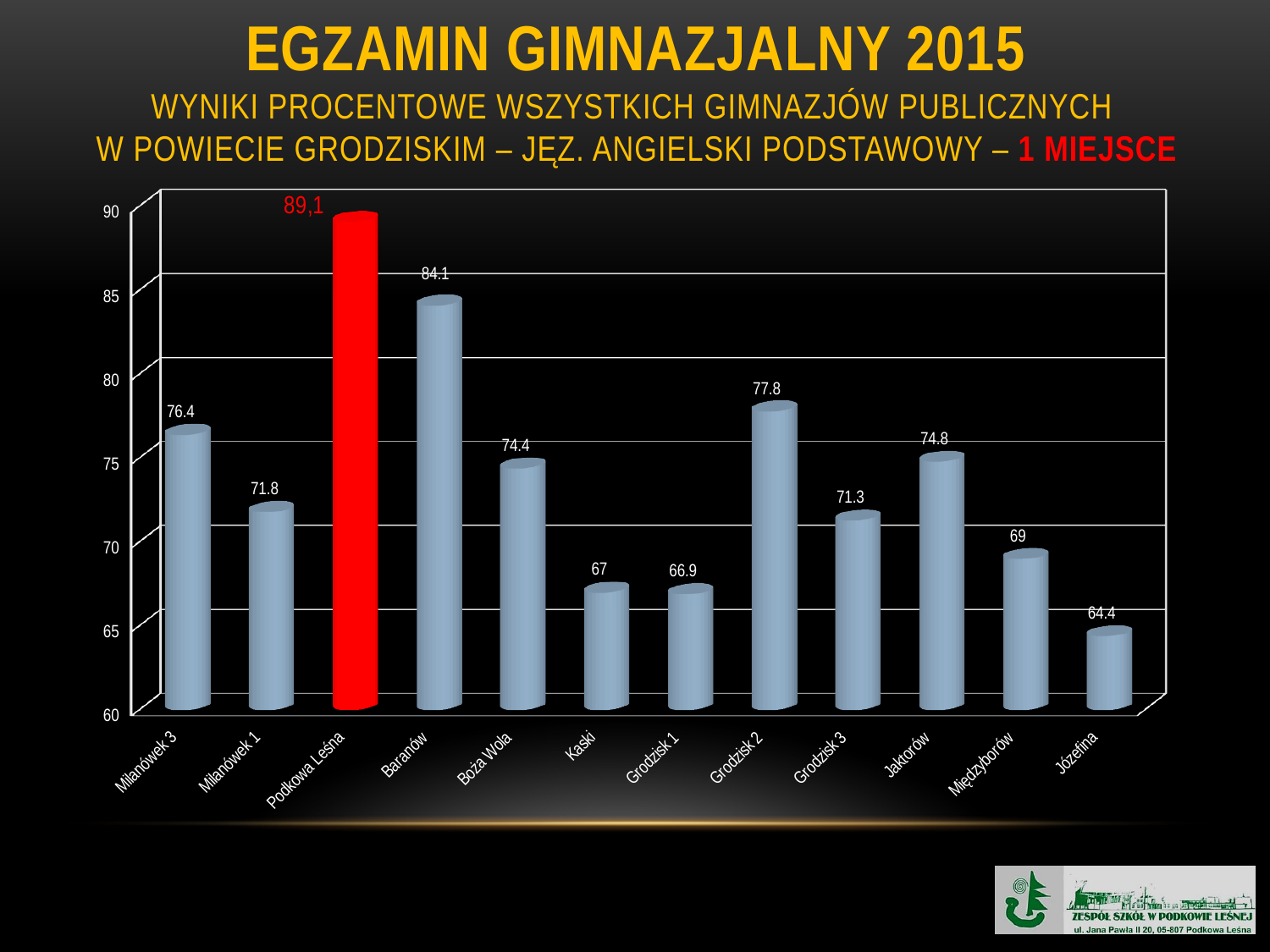
What is the value for Grodzisk 2? 77.8 What is the value for Podkowa Leśna? 89,1 How many categories are shown on the x axis? 12 Is the value for Międzyborów greater or less than 70? less Which category has the lowest value? Józefina Which is larger, the value for Jaktorów or the value for Boża Wola? Jaktorów What is the value for Józefina? 64.4 Which category has the highest value? Podkowa Leśna Which bar is coloured red instead of blue-grey? Podkowa Leśna What is the value for Baranów? 84.1 What is the difference between the values for Baranów and Milanówek 3? 7.7 What kind of chart is shown on the slide? bar chart